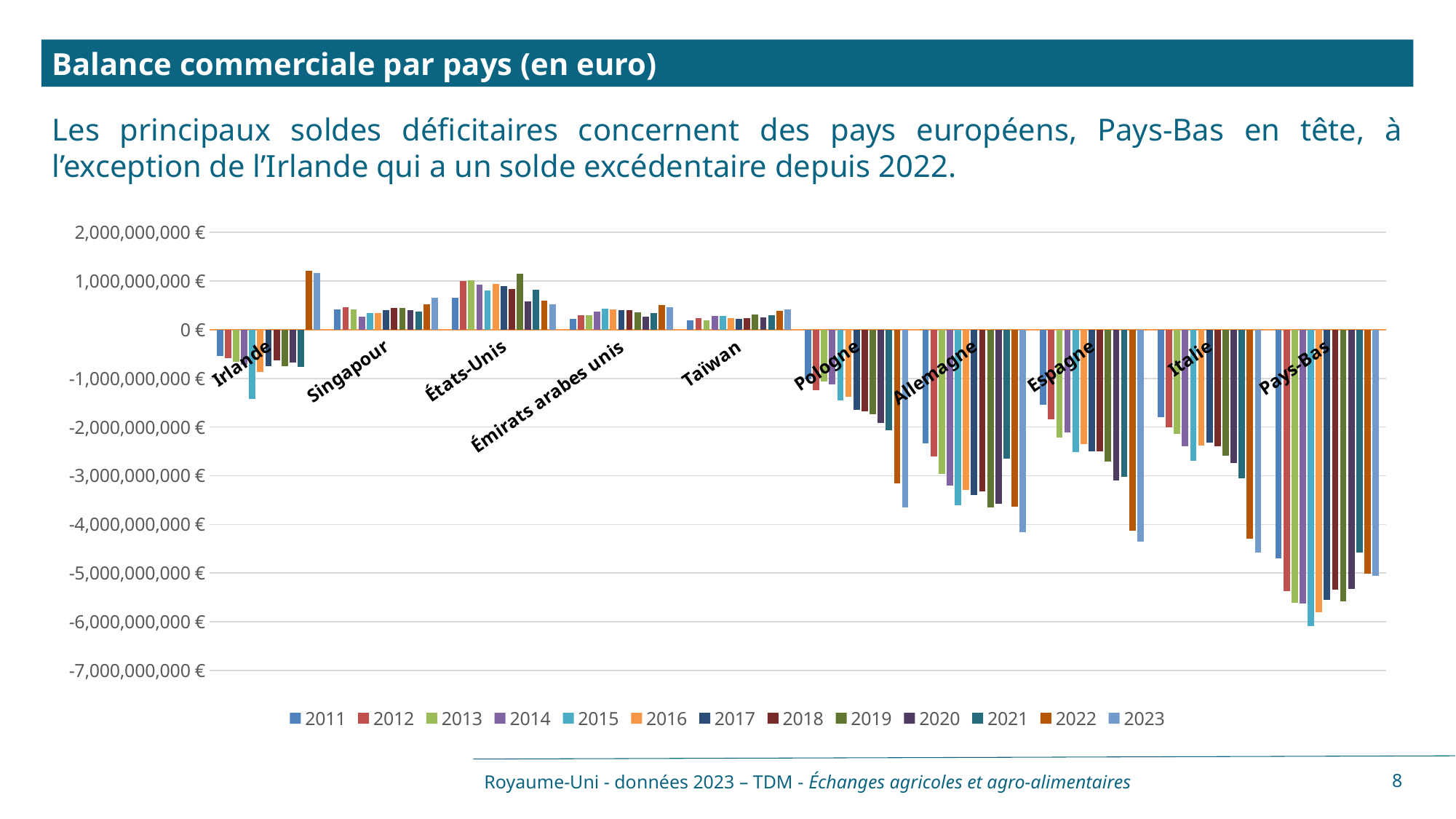
Which country has the highest value for 2022? Irlande How many series (years) does the legend list? 13 What kind of chart is shown on the slide? bar chart Which country has the lowest (most negative) value for 2023? Pays-Bas How many countries are shown on the x axis of the chart? 10 Is the value for Pays-Bas in 2015 greater or less than -5,000,000,000 €? less What is the title of the chart on the slide? Balance commerciale par pays (en euro) Which country has the highest value for 2023? Irlande Is the value for Irlande in 2022 greater or less than 1,000,000,000 €? greater Which is larger, the value for États-Unis in 2019 or the value for Singapour in 2019? États-Unis in 2019 Which is larger, the value for Pologne in 2023 or the value for Espagne in 2023? Pologne in 2023 Is the value for Allemagne in 2023 greater or less than -3,000,000,000 €? less